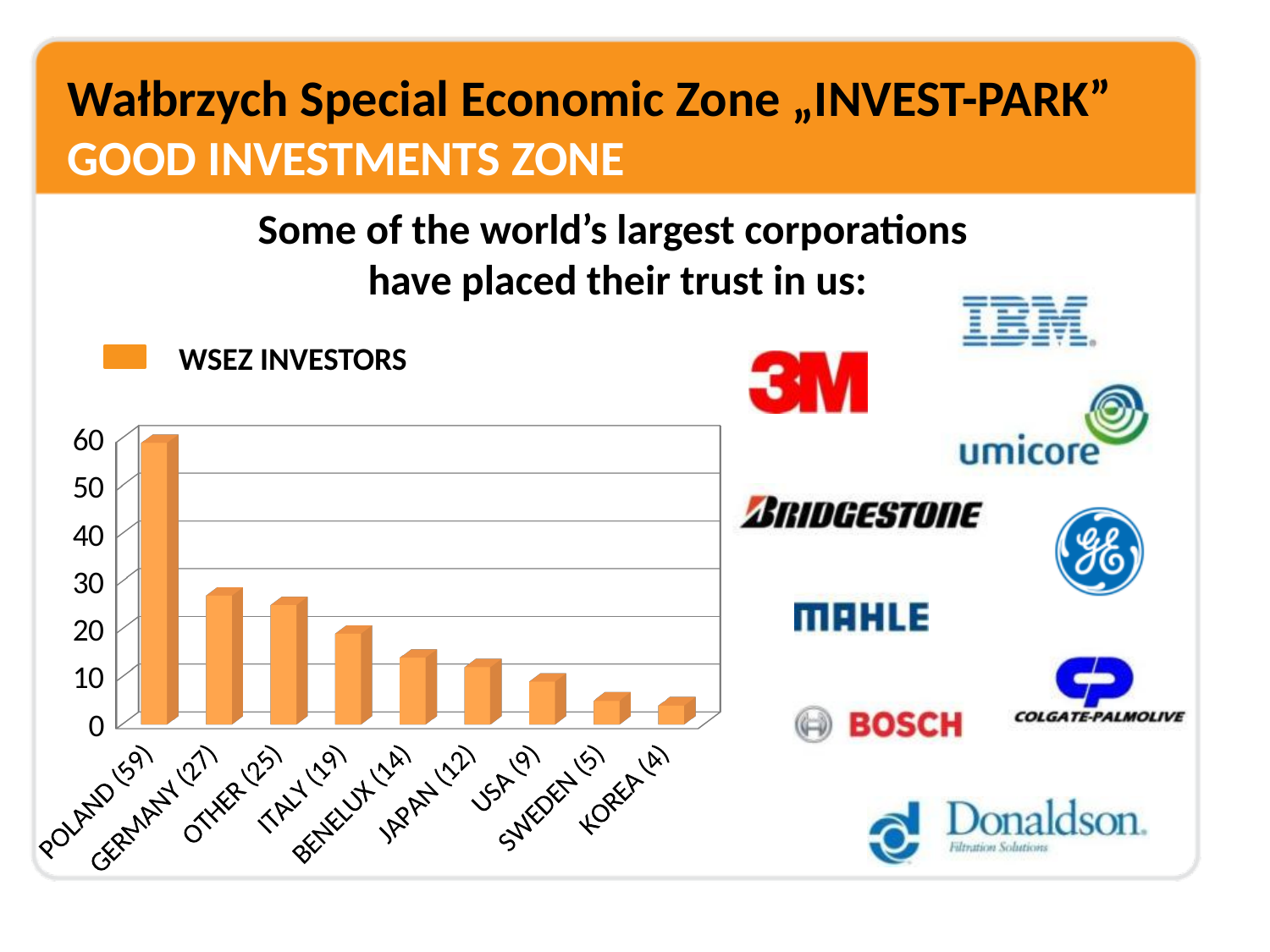
How many categories are shown on the x axis of the chart? 9 What is the difference between the values for Italy and Benelux? 5 What is the value shown for Germany in the WSEZ investors chart? 27 What is the value shown for Japan? 12 Which has a larger value, Other or Italy? OTHER Which category has the highest value in the chart? POLAND Which category has the lowest value in the chart? KOREA What type of chart is shown on the slide? bar chart How many investors does the chart show for Poland? 59 What is the difference between the values for Poland and Germany? 32 How many series does the chart legend list? 1 Is the value for USA greater or less than 10? less